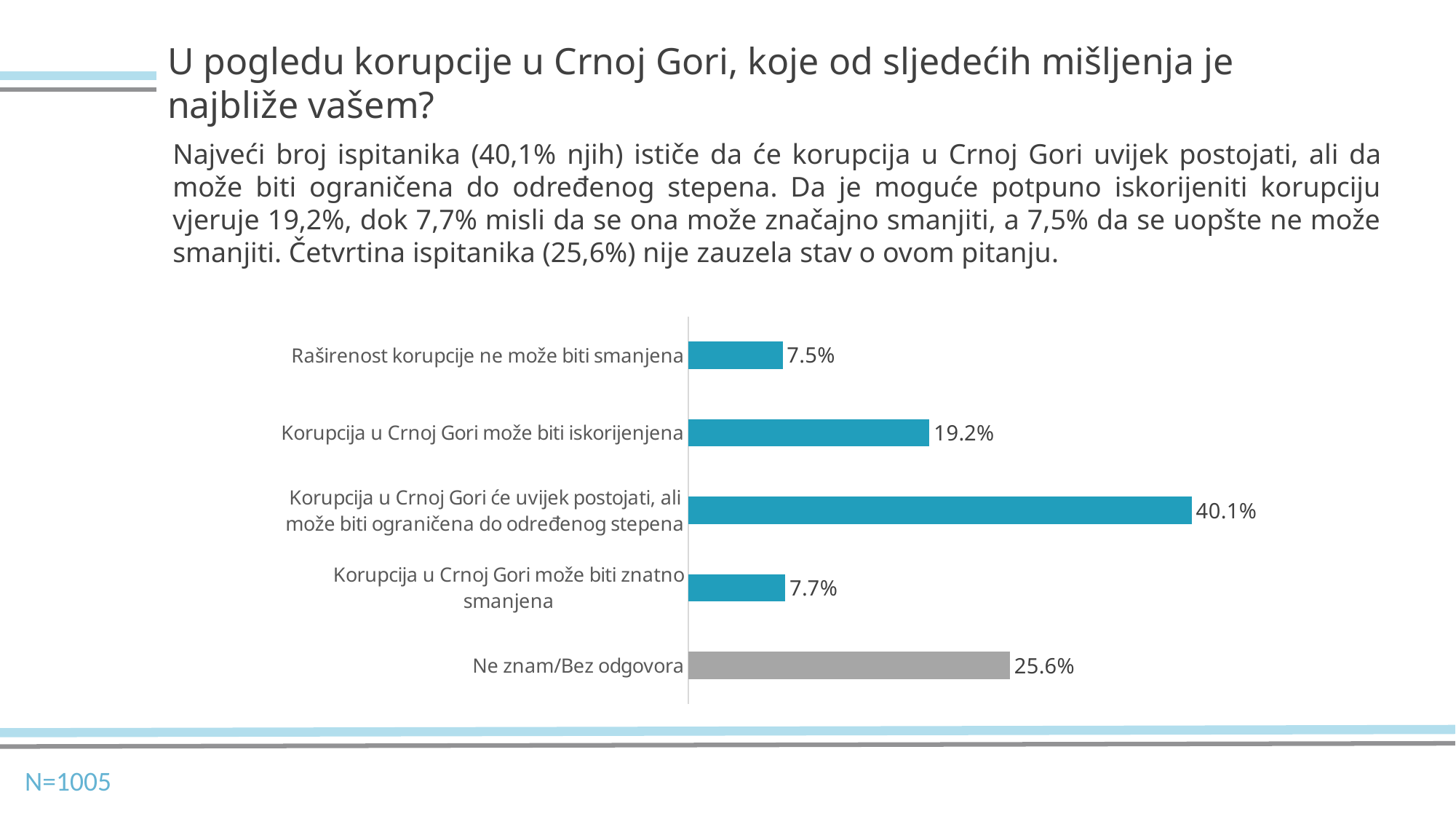
Which bar is shown in grey rather than blue? Ne znam/Bez odgovora Which category has the highest value? Korupcija u Crnoj Gori će uvijek postojati, ali može biti ograničena do određenog stepena Which is larger: the value for "Korupcija u Crnoj Gori može biti iskorijenjena" or the value for "Ne znam/Bez odgovora"? Ne znam/Bez odgovora How many categories are shown in the chart? 5 What is the value for "Korupcija u Crnoj Gori će uvijek postojati, ali može biti ograničena do određenog stepena"? 40.1% What is the value for "Korupcija u Crnoj Gori može biti iskorijenjena"? 19.2% What is the difference between the values for "Korupcija u Crnoj Gori može biti znatno smanjena" and "Raširenost korupcije ne može biti smanjena"? 0.2% What is the value for "Raširenost korupcije ne može biti smanjena"? 7.5% Which category has the lowest value? Raširenost korupcije ne može biti smanjena What is the difference between the values for "Ne znam/Bez odgovora" and "Korupcija u Crnoj Gori može biti iskorijenjena"? 6.4% What is the value for "Ne znam/Bez odgovora"? 25.6% What kind of chart is shown on the slide? Bar chart